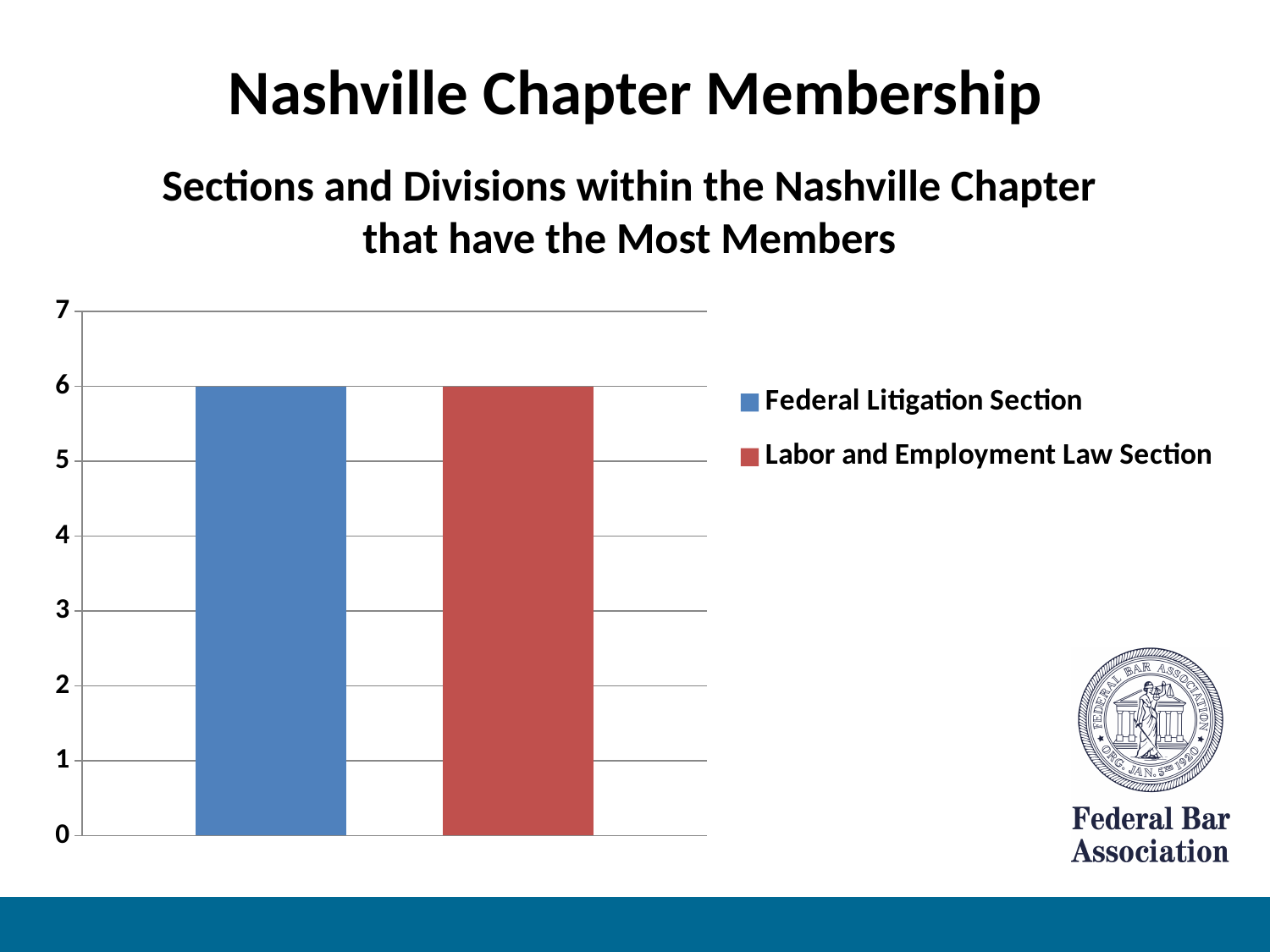
What is the value for the Federal Litigation Section? 6 What is the value for the Labor and Employment Law Section? 6 Is the value for the Federal Litigation Section greater or less than 5? greater What is the highest value shown on the vertical axis? 7 What is the title of the chart? Sections and Divisions within the Nashville Chapter that have the Most Members What is the difference between the values for the Federal Litigation Section and the Labor and Employment Law Section? 0 How many series does the legend list? 2 What type of chart is shown on the slide? bar chart How many bars are plotted in the chart? 2 Is the value for the Labor and Employment Law Section greater or less than 7? less